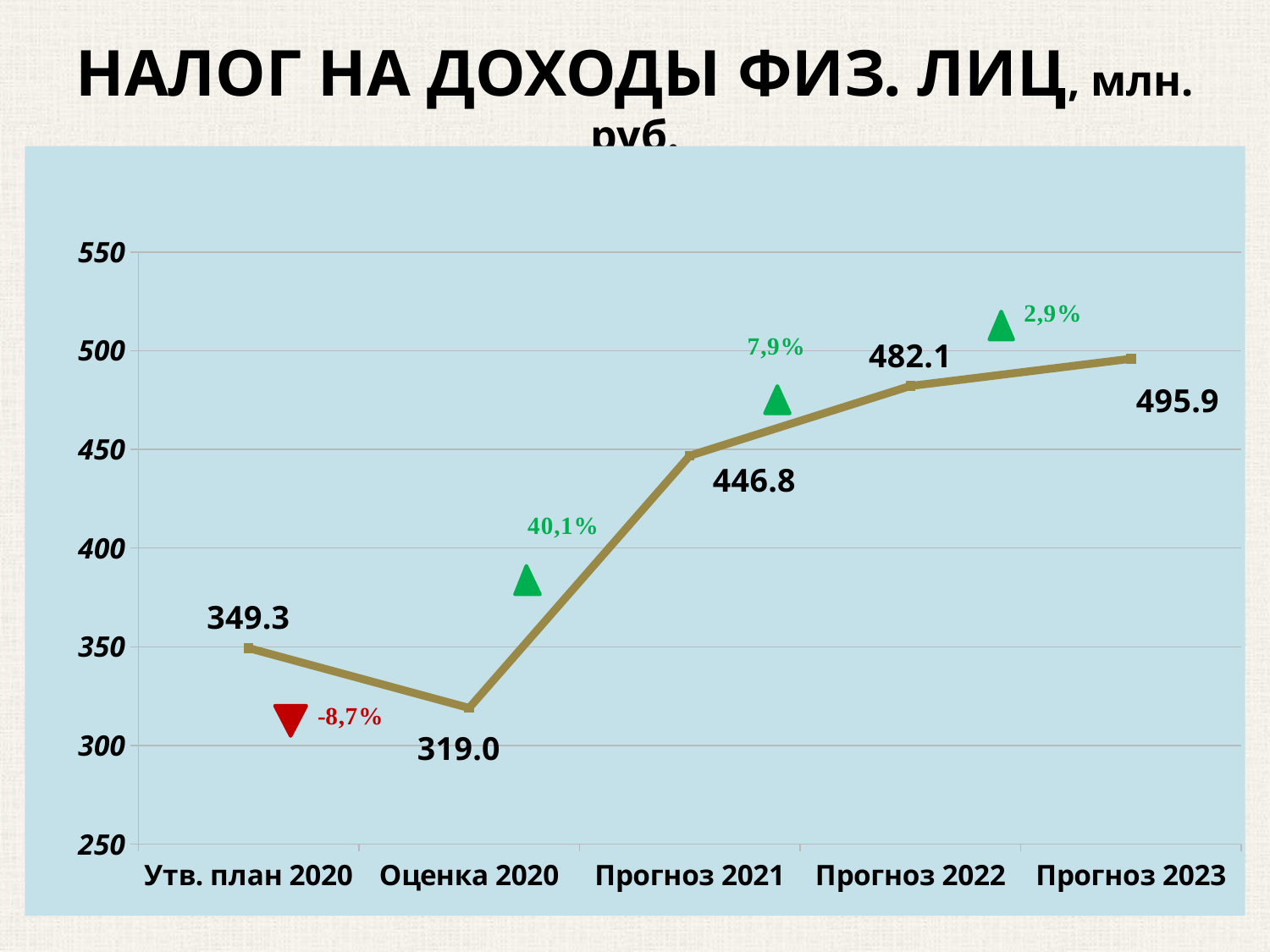
Which category has the highest value? Прогноз 2023 How many categories are shown on the x axis? 5 What is the value for Утв. план 2020? 349.3 Which category has the lowest value? Оценка 2020 Which is larger, the value for Прогноз 2021 or the value for Утв. план 2020? Прогноз 2021 What is the value for Оценка 2020? 319.0 Is the value for Прогноз 2021 greater or less than 400? greater What percentage change is shown between Оценка 2020 and Прогноз 2021? 40,1% What is the value for Прогноз 2022? 482.1 What kind of chart is shown on the slide? line chart What is the difference between the values for Утв. план 2020 and Оценка 2020? 30.3 What is the difference between the values for Прогноз 2023 and Прогноз 2022? 13.8